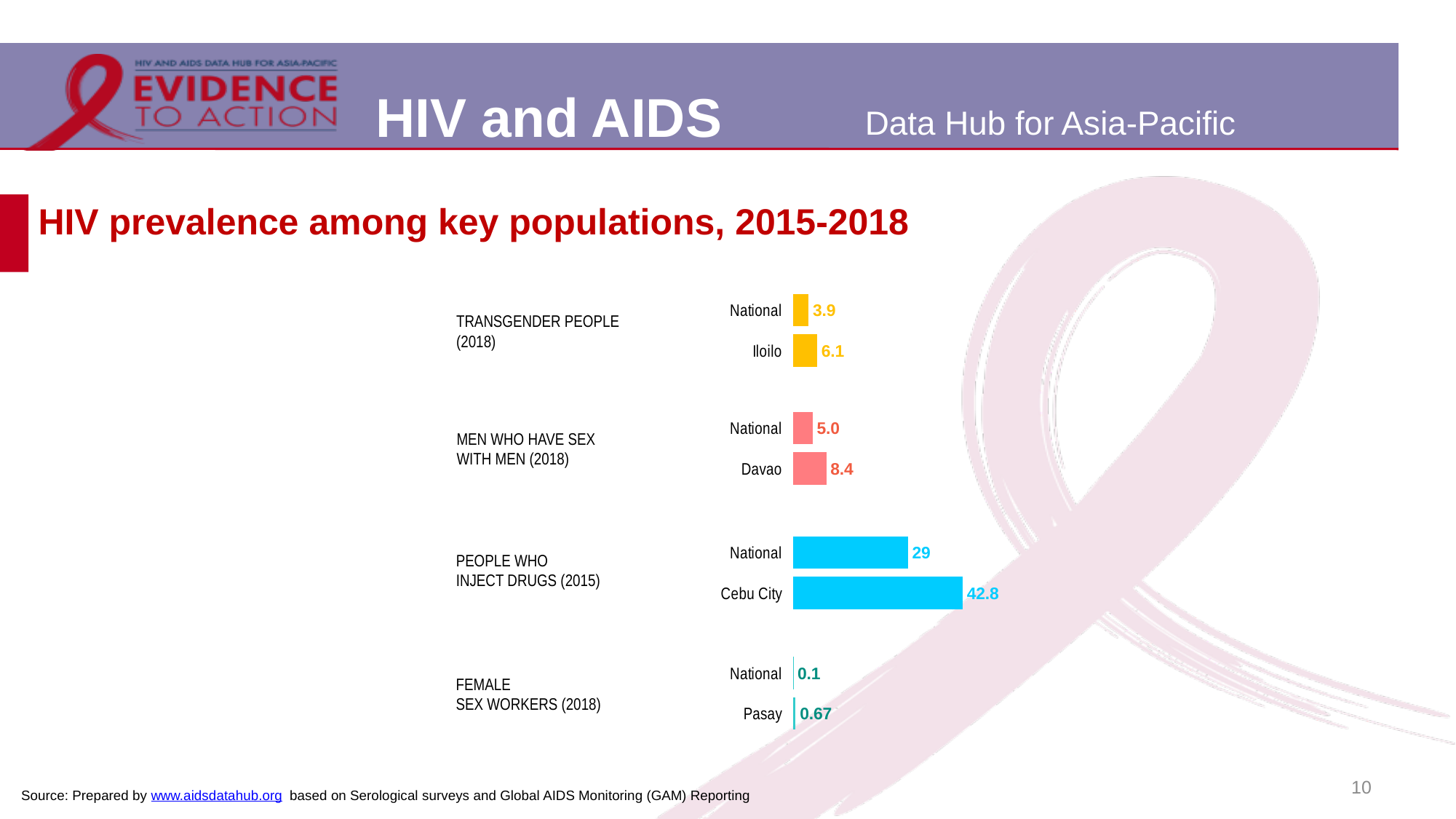
What is the HIV prevalence value for Transgender People (2018) at the National level? 3.9 What is the HIV prevalence value for People Who Inject Drugs (2015) in Cebu City? 42.8 Which bar has the highest value on the chart? Cebu City (People Who Inject Drugs, 2015) What is the HIV prevalence value for Female Sex Workers (2018) in Pasay? 0.67 Which bar has the lowest value on the chart? National (Female Sex Workers, 2018) Which is larger, the Iloilo value for Transgender People or the National value for Men Who Have Sex With Men? Iloilo value for Transgender People How many bars are plotted on the chart? 8 What is the HIV prevalence value for Men Who Have Sex With Men (2018) in Davao? 8.4 What is the HIV prevalence value for Transgender People (2018) in Iloilo? 6.1 What is the difference between the Davao and National values for Men Who Have Sex With Men (2018)? 3.4 What kind of chart is shown on the slide? Bar chart What is the difference between the Cebu City and National values for People Who Inject Drugs (2015)? 13.8